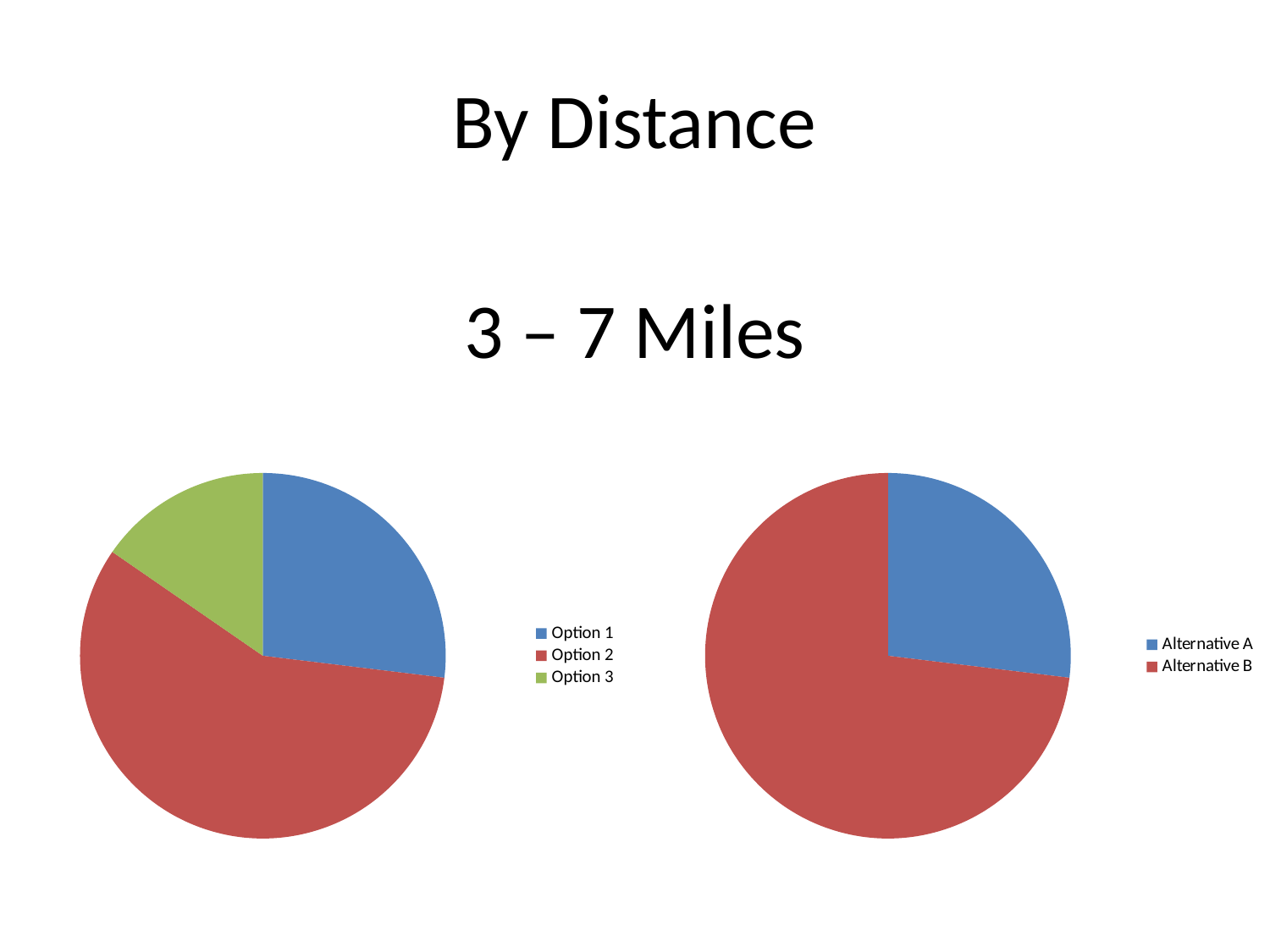
What are the legend entries of the right pie chart? Alternative A, Alternative B What kind of chart is the chart on the left of the slide? pie chart In the right pie chart, which category has the largest slice? Alternative B In the right pie chart, how many slices are there? 2 In the right pie chart, which category has the smallest slice? Alternative A In the left pie chart, what colour is the Option 3 slice? green In the left pie chart, how many slices are there? 3 In the left pie chart, which category has the largest slice? Option 2 What kind of chart is the chart on the right of the slide? pie chart In the left pie chart, which category has the smallest slice? Option 3 In the right pie chart, which is larger, Alternative A or Alternative B? Alternative B In the left pie chart, which is larger, Option 1 or Option 3? Option 1